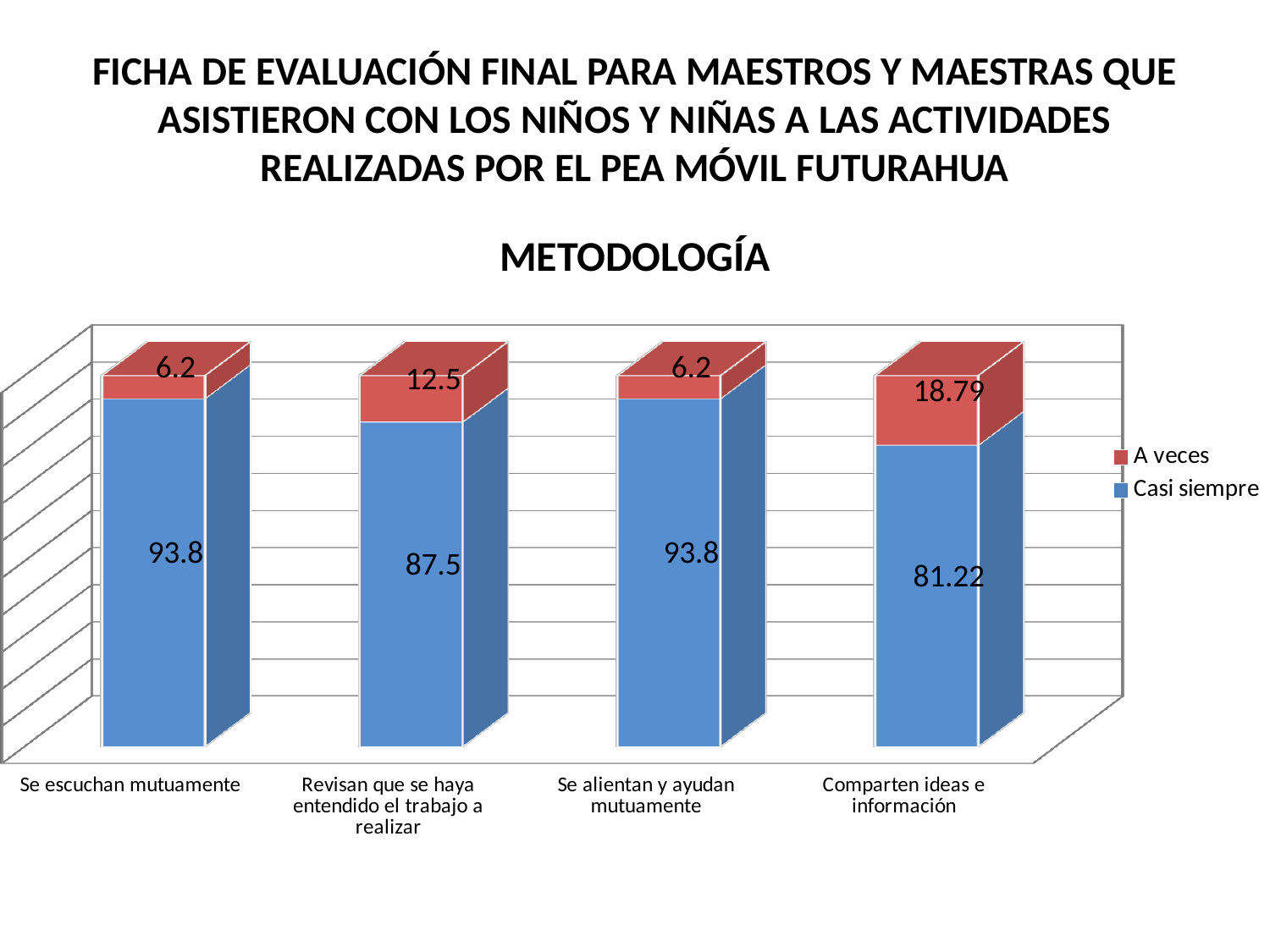
What is the 'Casi siempre' value for 'Comparten ideas e información'? 81.22 What is the total of the stacked bar for 'Se escuchan mutuamente'? 100 What is the 'A veces' value for 'Revisan que se haya entendido el trabajo a realizar'? 12.5 How many categories are shown on the x axis of the chart? 4 What is the 'Casi siempre' value for 'Se escuchan mutuamente'? 93.8 Which category has the lowest 'Casi siempre' value? Comparten ideas e información Which is larger: the 'A veces' value for 'Comparten ideas e información' or for 'Revisan que se haya entendido el trabajo a realizar'? Comparten ideas e información What is the difference between the 'Casi siempre' values for 'Se escuchan mutuamente' and 'Revisan que se haya entendido el trabajo a realizar'? 6.3 Which category has the highest 'A veces' value? Comparten ideas e información What is the 'A veces' value for 'Se alientan y ayudan mutuamente'? 6.2 What kind of chart is shown on the slide? Stacked bar chart How many series does the legend list? 2